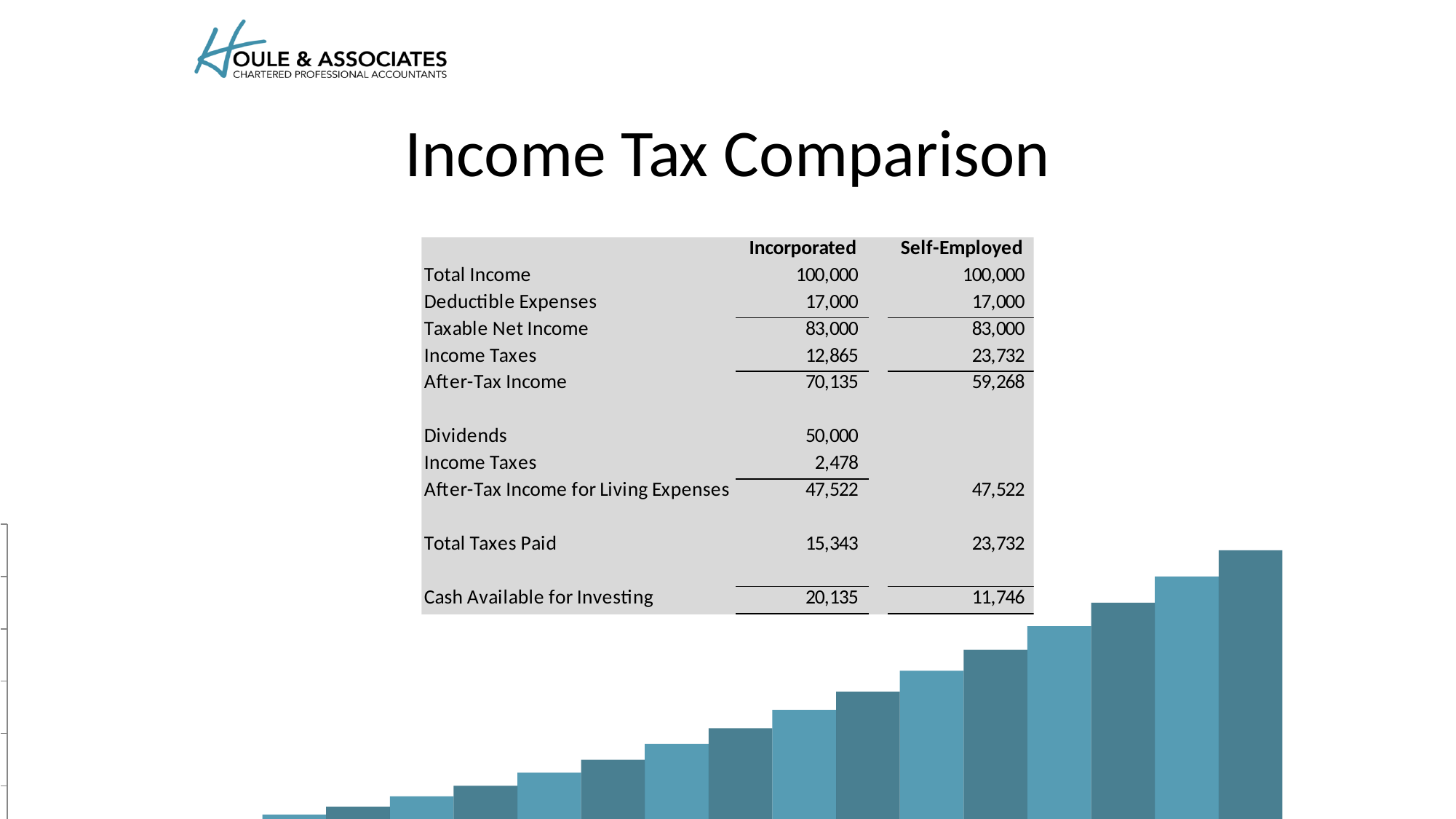
What kind of chart is shown at the bottom of the slide? bar chart In the bar chart at the bottom of the slide, is the rightmost bar taller or shorter than the leftmost bar? taller In the bar chart at the bottom of the slide, which bar is the shortest? the leftmost bar Does the bar chart at the bottom of the slide show any data labels or axis labels? No In the bar chart at the bottom of the slide, do the bar heights rise or fall from left to right? rise In the bar chart at the bottom of the slide, which bar is the tallest? the rightmost bar What colours are the bars in the bar chart at the bottom of the slide? alternating light and dark teal blue